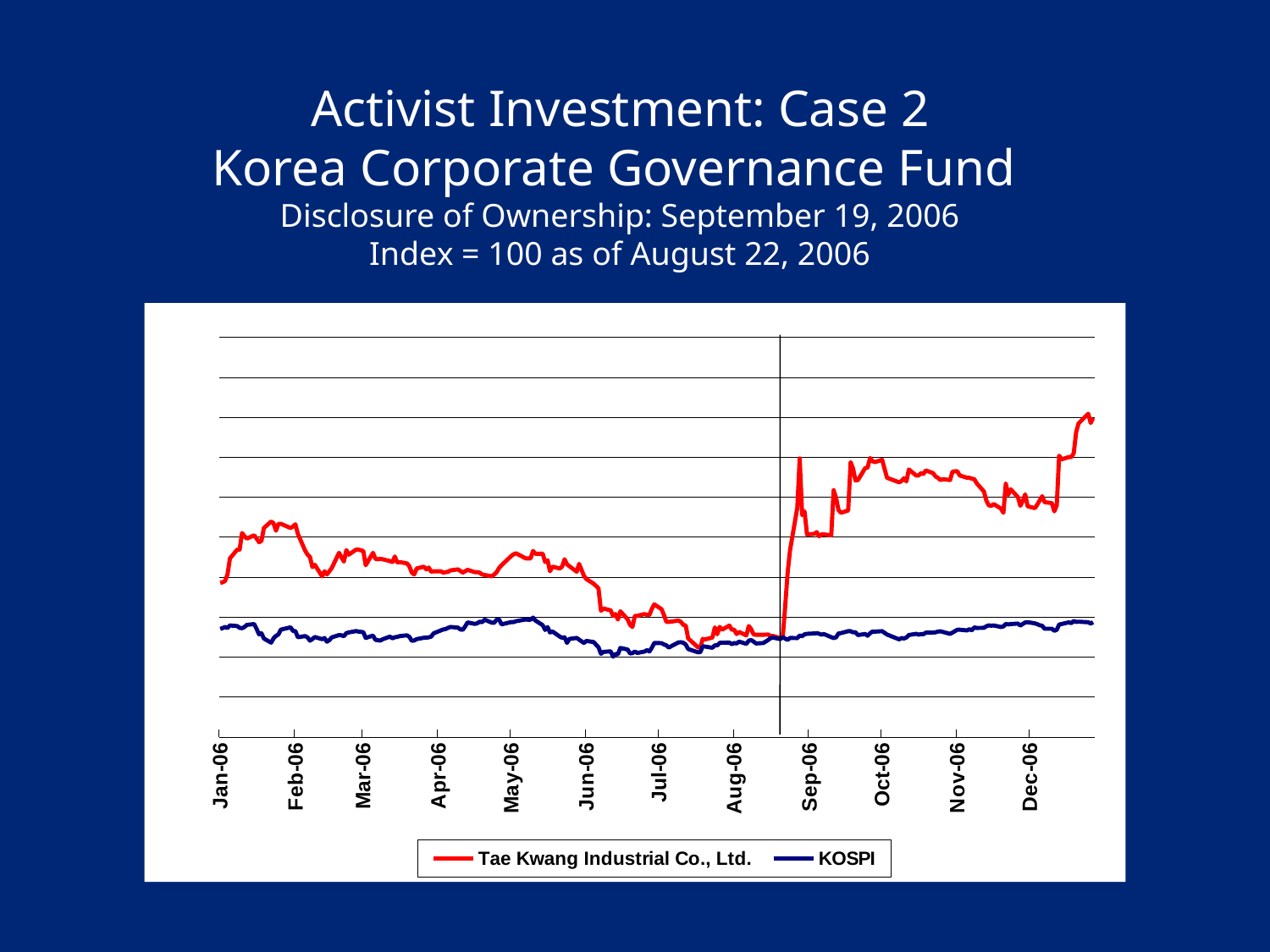
Which series is higher at Jan-06, Tae Kwang Industrial Co., Ltd. or KOSPI? Tae Kwang Industrial Co., Ltd. Does the KOSPI line rise or fall from Jul-06 to Dec-06? Rise Which series reaches the lowest point on the chart? KOSPI What colour is the KOSPI line? Blue Does the Tae Kwang Industrial Co., Ltd. line rise or fall from Feb-06 to Jul-06? Fall How many month labels are shown on the x axis? 12 What kind of chart is shown on the slide? Line chart Which series reaches the highest point on the chart? Tae Kwang Industrial Co., Ltd. Which series is higher at Dec-06, Tae Kwang Industrial Co., Ltd. or KOSPI? Tae Kwang Industrial Co., Ltd. What are the two series named in the legend? Tae Kwang Industrial Co., Ltd. and KOSPI Does the Tae Kwang Industrial Co., Ltd. line rise or fall between Aug-06 and Sep-06? Rise How many series does the legend list? 2